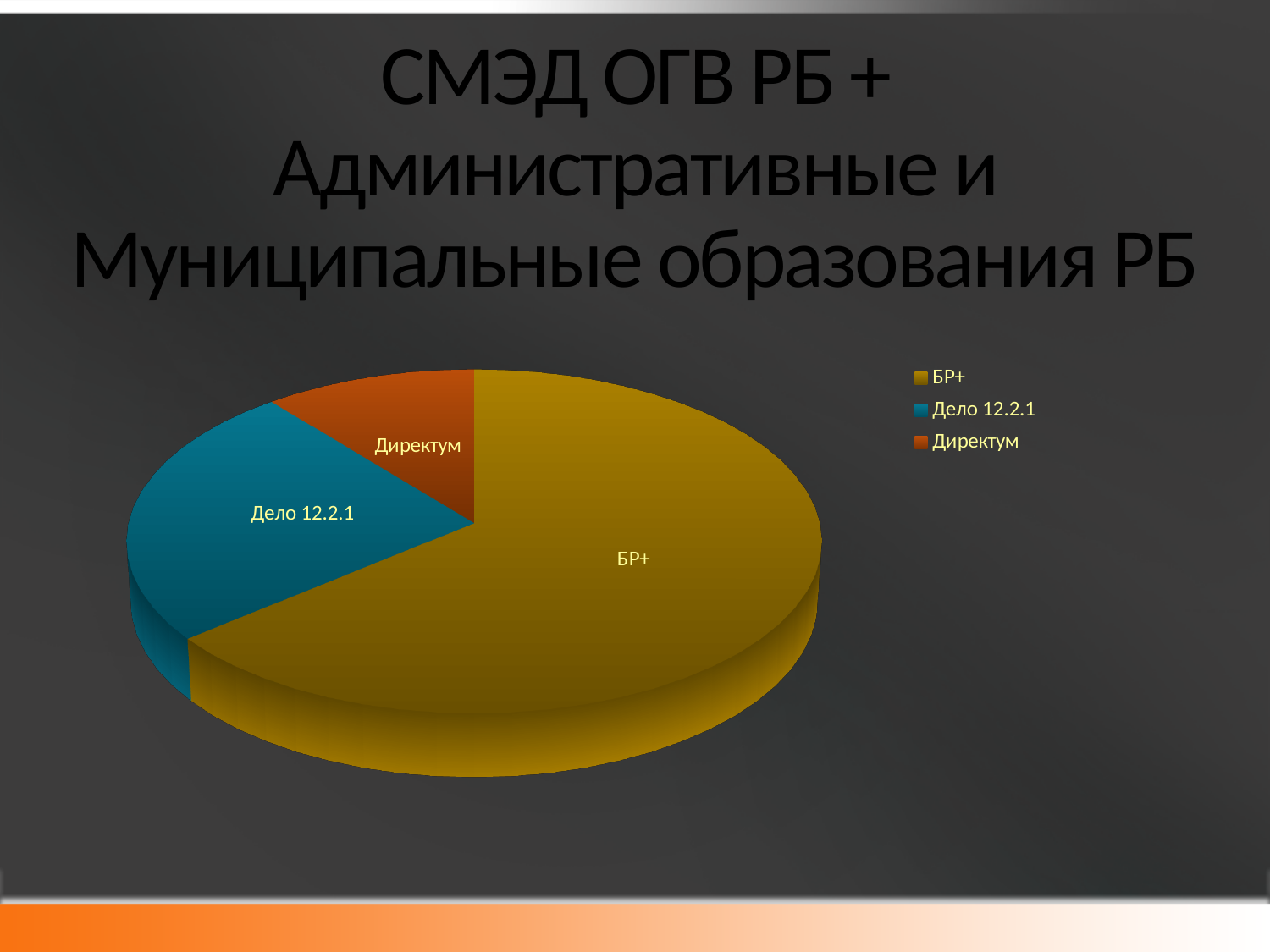
Which slice is larger, Дело 12.2.1 or Директум? Дело 12.2.1 Does the БР+ slice take up more or less than half of the pie? more What is the title shown above the pie chart on the slide? СМЭД ОГВ РБ + Административные и Муниципальные образования РБ How many slices does the pie chart have? 3 How many entries does the legend of the pie chart list? 3 Which slice is larger, БР+ or Дело 12.2.1? БР+ What kind of chart is shown on the slide? pie chart Which category has the largest slice in the pie chart? БР+ Which category has the smallest slice in the pie chart? Директум What colour is the Дело 12.2.1 slice in the pie chart? blue (teal)